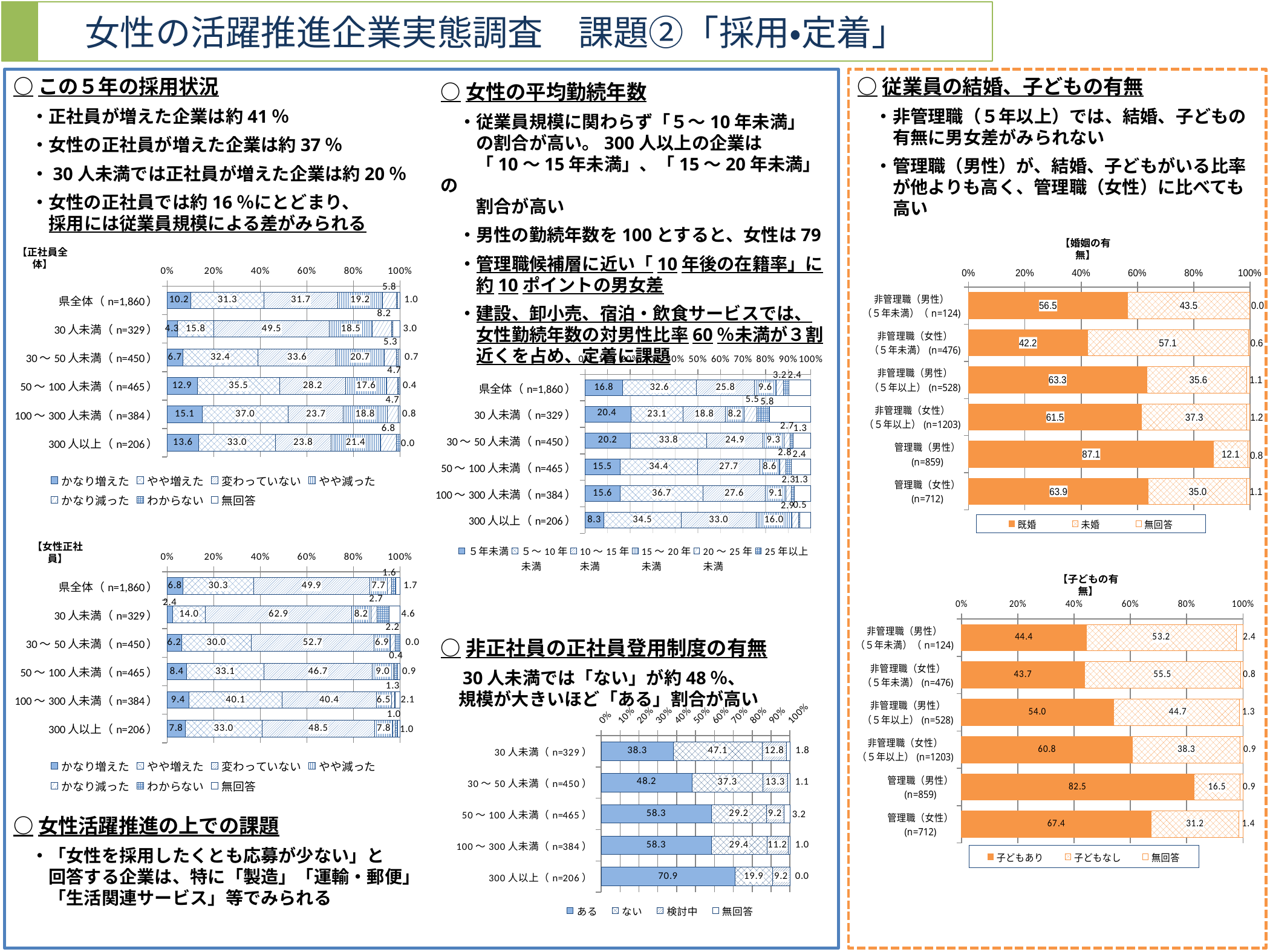
How many categories are shown in the 【婚姻の有無】 chart? 6 In the 【女性正社員】 chart, what is the 変わっていない value for 30人未満（n=329）? 62.9 In the 【婚姻の有無】 chart, what is the 既婚 value for 管理職（男性）(n=859)? 87.1 In the 【子どもの有無】 chart, which is larger for 子どもあり: 管理職（男性） or 管理職（女性）? 管理職（男性） How many series does the legend of the 非正社員の正社員登用制度の有無 chart list? 4 What kind of chart is the 【子どもの有無】 chart? Stacked bar chart In the 女性の平均勤続年数 chart, what is the 5年未満 value for 県全体（n=1,860）? 16.8 In the 非正社員の正社員登用制度の有無 chart, what is the ある value for 300人以上（n=206）? 70.9 In the 【婚姻の有無】 chart, which category has the lowest 既婚 value? 非管理職（女性）（5年未満）(n=476) In the 非正社員の正社員登用制度の有無 chart, what is the difference between the ある values for 300人以上（n=206） and 30人未満（n=329）? 32.6 In the 【子どもの有無】 chart, which category has the highest 子どもあり value? 管理職（男性）(n=859) In the 【正社員全体】 chart, what is the 変わっていない value for 30人未満（n=329）? 49.5